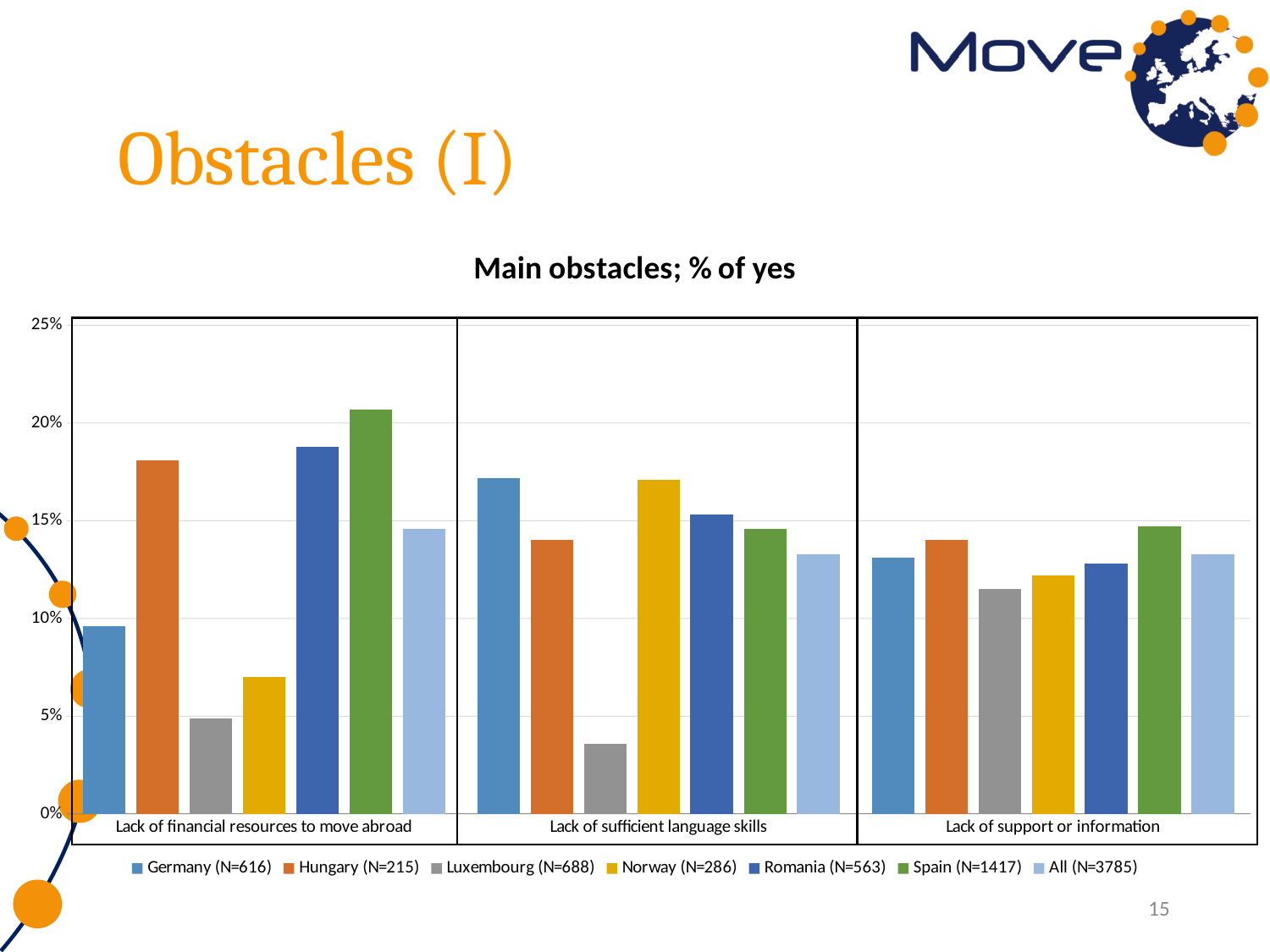
Is the value for Luxembourg under 'Lack of sufficient language skills' greater or less than 5%? less What kind of chart is shown on the slide? Bar chart How many series does the legend list? 7 Is the value for Hungary under 'Lack of financial resources to move abroad' greater or less than 15%? greater What is the title of the chart? Main obstacles; % of yes Which country has the highest value for 'Lack of support or information'? Spain (N=1417) For 'Lack of financial resources to move abroad', which is larger: Germany or Hungary? Hungary (N=215) Which country has the highest value for 'Lack of financial resources to move abroad'? Spain (N=1417) For 'Lack of sufficient language skills', which is larger: Germany or Luxembourg? Germany (N=616) Which country has the lowest value for 'Lack of financial resources to move abroad'? Luxembourg (N=688) Which country has the lowest value for 'Lack of sufficient language skills'? Luxembourg (N=688) How many obstacle categories are shown on the x axis? 3